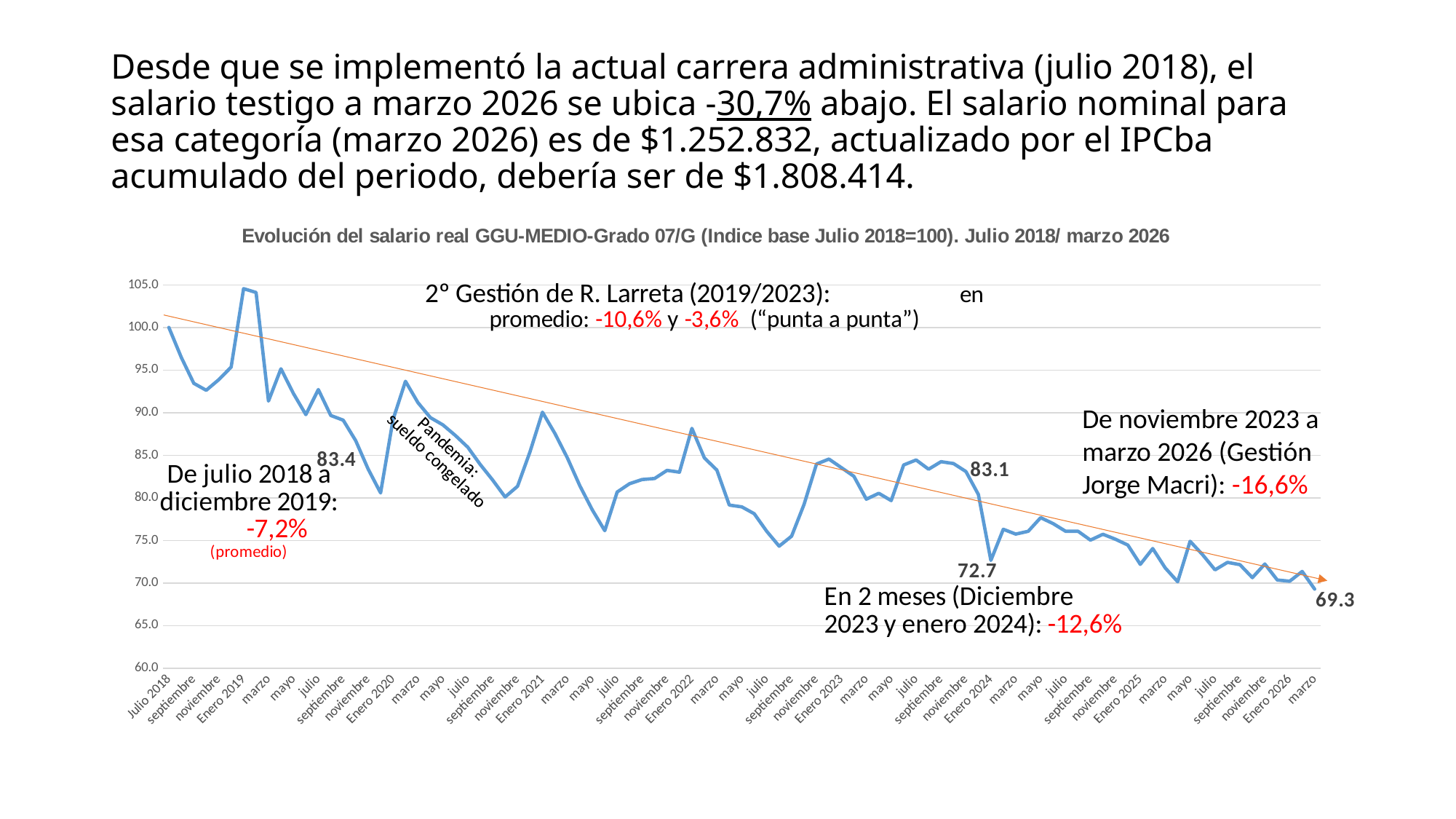
What kind of chart is shown on the slide? line chart What is the difference between the labelled values 83.1 and 72.7? 10.4 Is the value for Enero 2019 greater or less than 100? greater Is the value for Julio 2018 greater or less than 95? greater What is the base value of the index according to the chart title? Julio 2018=100 What value is labelled on the line just before the drop at the end of 2023 (noviembre 2023)? 83.1 What value is labelled at the dip at Enero 2024? 72.7 Which is larger, the value at Enero 2019 or the value at Julio 2018? Enero 2019 What is the value of the index at marzo 2026, the last point on the chart? 69.3 Overall, do the values rise or fall from Julio 2018 to marzo 2026? fall What is the difference between the labelled value at Enero 2024 (72.7) and the final value at marzo 2026 (69.3)? 3.4 Which month shows the highest value on the chart? Enero 2019